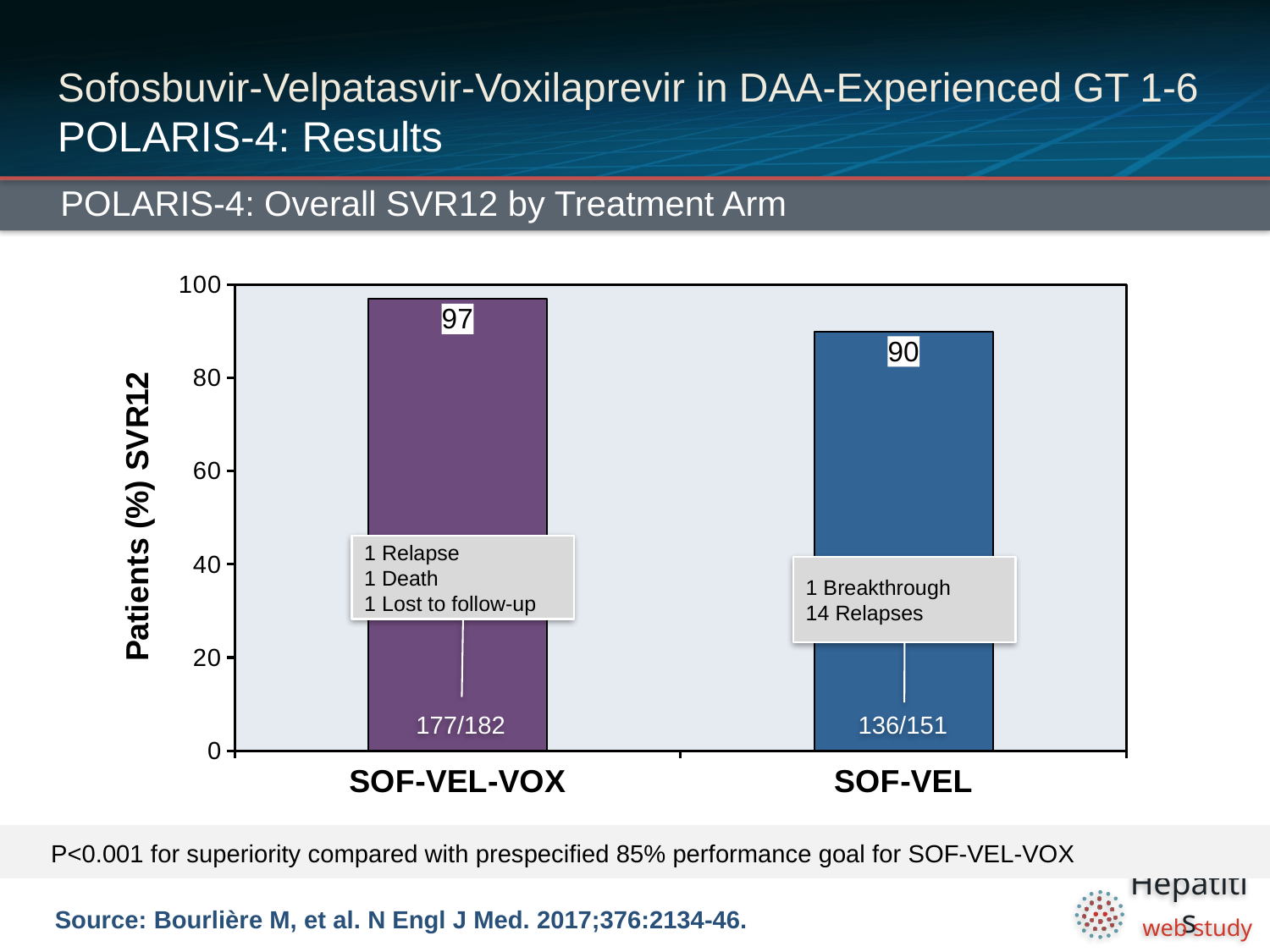
What fraction of patients is shown at the base of the SOF-VEL-VOX bar? 177/182 What is the title of the chart? POLARIS-4: Overall SVR12 by Treatment Arm What is the SVR12 value for SOF-VEL? 90 Which treatment arm has the highest SVR12 rate? SOF-VEL-VOX What kind of chart is shown on the slide? Bar chart What fraction of patients is shown at the base of the SOF-VEL bar? 136/151 What is the SVR12 value for SOF-VEL-VOX? 97 Is the value for SOF-VEL greater or less than 80? greater How many treatment arms are shown in the chart? 2 Which treatment arm has the lowest SVR12 rate? SOF-VEL Which is larger, the SVR12 for SOF-VEL-VOX or for SOF-VEL? SOF-VEL-VOX What is the difference in SVR12 between SOF-VEL-VOX and SOF-VEL? 7